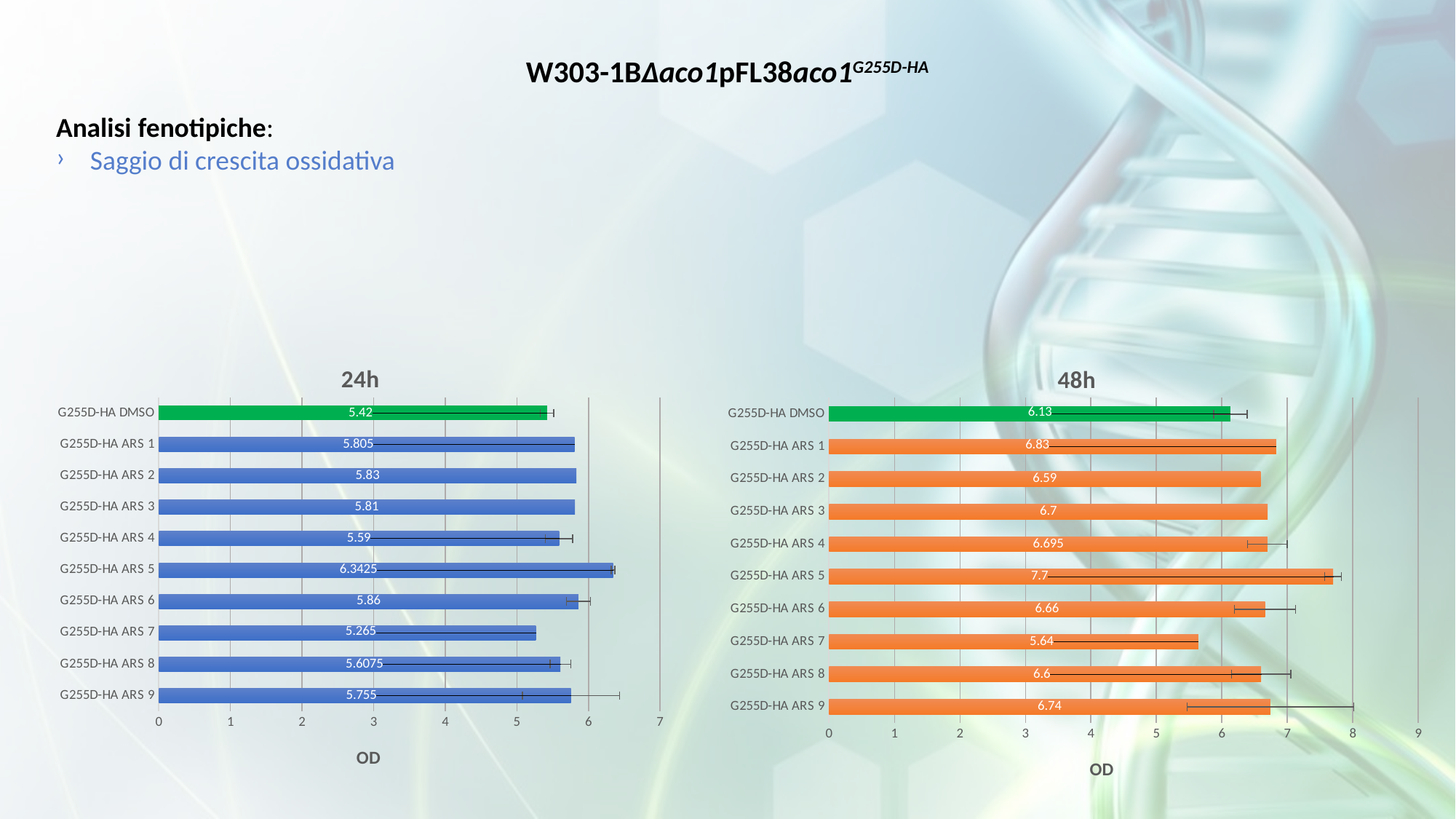
In the 48h chart, what is the value for G255D-HA ARS 4? 6.695 What is the x-axis label of the 48h chart? OD In the 48h chart, what is the difference between the values for G255D-HA ARS 5 and G255D-HA DMSO? 1.57 In the 24h chart, what is the value for G255D-HA DMSO? 5.42 In the 48h chart, is the value for G255D-HA ARS 7 greater or less than 6? less In the 48h chart, what is the value for G255D-HA ARS 5? 7.7 What kind of chart is the 24h chart? bar chart In the 24h chart, what is the value for G255D-HA ARS 8? 5.6075 In the 24h chart, which is larger, the value for G255D-HA ARS 7 or G255D-HA ARS 6? G255D-HA ARS 6 How many categories are shown in the 48h chart? 10 In the 24h chart, which category has the highest value? G255D-HA ARS 5 In the 48h chart, which category has the lowest value? G255D-HA ARS 7